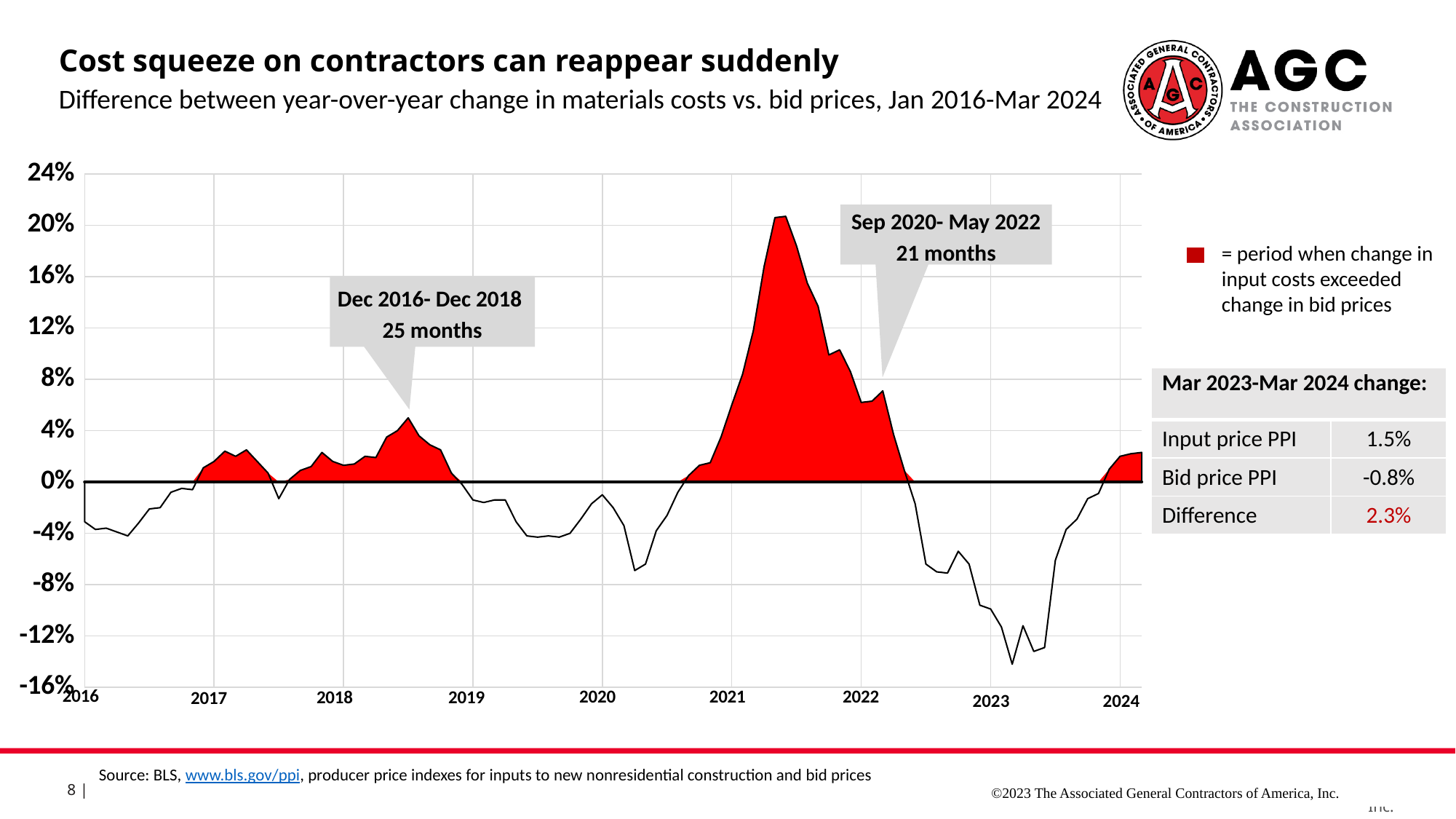
According to the chart annotation, how many months did the Dec 2016-Dec 2018 period last? 25 months Is the value of the line at the start of 2016 greater or less than 0%? less Is the value of the line at the end of the series in 2024 greater or less than 0%? greater According to the chart annotation, how many months did the Sep 2020-May 2022 period last? 21 months What do the red shaded areas on the chart represent? period when change in input costs exceeded change in bid prices Does the line rise or fall between the start of 2022 and the start of 2023? fall What kind of chart is shown on the slide? area chart In the Mar 2023-Mar 2024 change table, what is the Difference? 2.3% Is the lowest value of the line in 2023 greater or less than -12%? less In the Mar 2023-Mar 2024 change table, what is the value for Bid price PPI? -0.8% In the Mar 2023-Mar 2024 change table, what is the value for Input price PPI? 1.5%